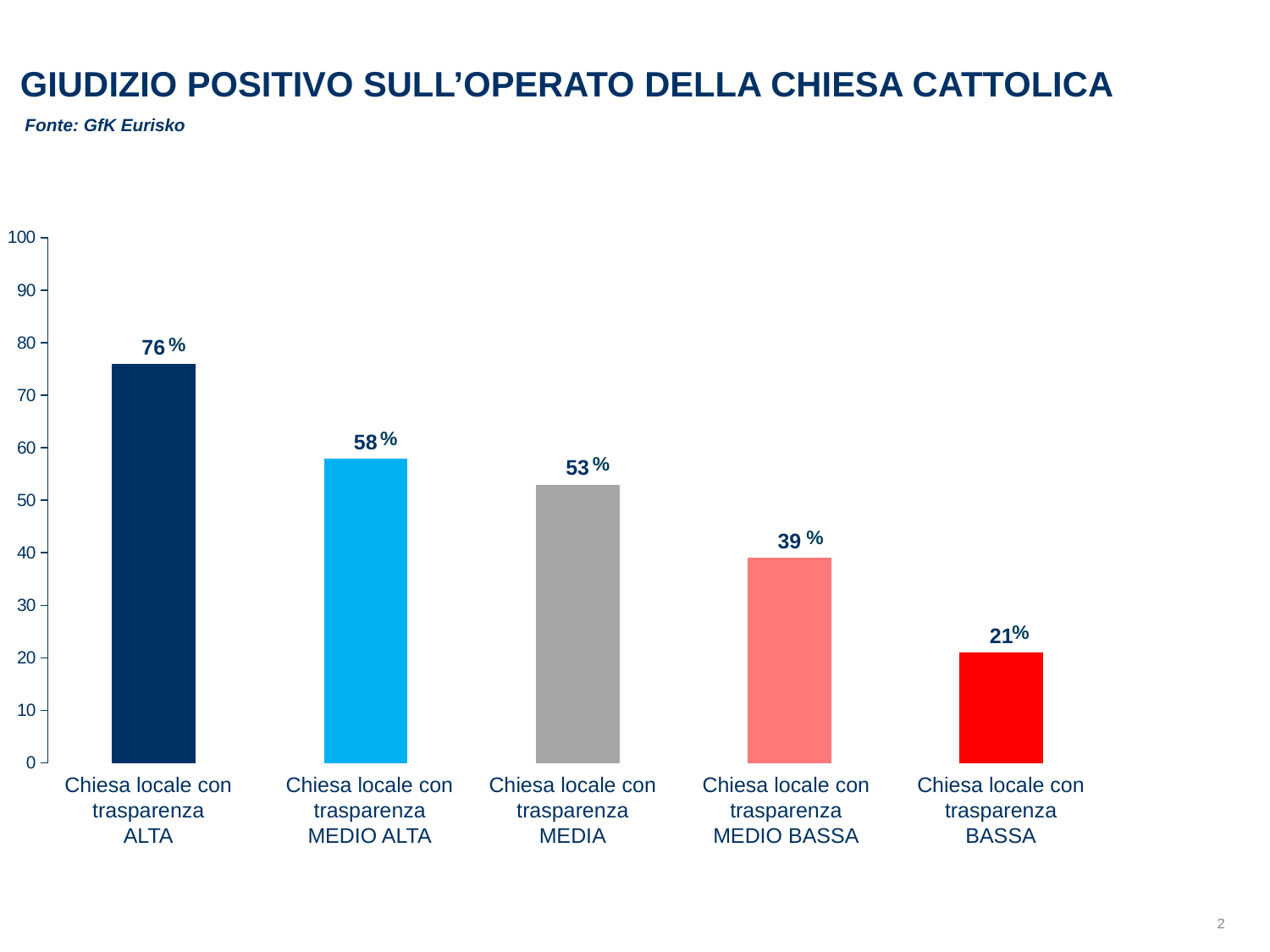
Is the value for 'Chiesa locale con trasparenza MEDIO ALTA' greater or less than 50? greater Which is larger: the value for 'Chiesa locale con trasparenza MEDIA' or 'Chiesa locale con trasparenza MEDIO BASSA'? Chiesa locale con trasparenza MEDIA What is the value for 'Chiesa locale con trasparenza ALTA'? 76% Which category has the highest value? Chiesa locale con trasparenza ALTA What kind of chart is shown on the slide? Bar chart What is the value for 'Chiesa locale con trasparenza MEDIO BASSA'? 39% Which category has the lowest value? Chiesa locale con trasparenza BASSA Do the values rise or fall from left to right across the categories? Fall What is the difference between the values for 'Chiesa locale con trasparenza ALTA' and 'Chiesa locale con trasparenza BASSA'? 55% What is the difference between the values for 'Chiesa locale con trasparenza MEDIO ALTA' and 'Chiesa locale con trasparenza MEDIA'? 5% How many categories are shown in the chart? 5 What is the value for 'Chiesa locale con trasparenza BASSA'? 21%